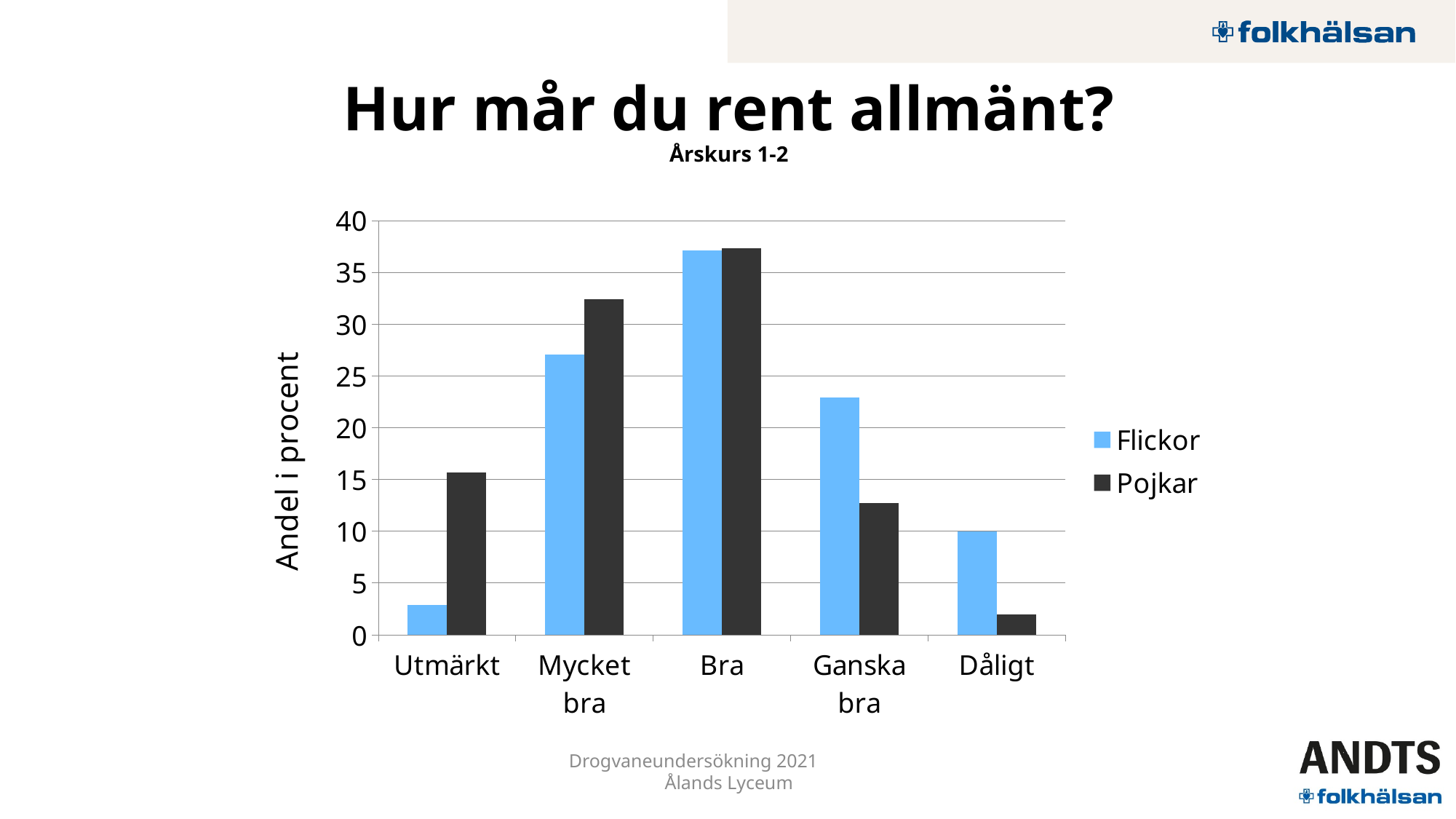
What kind of chart is shown on the slide? bar chart Which category has the lowest value for Pojkar? Dåligt For Utmärkt, which series has the larger value, Flickor or Pojkar? Pojkar Which category has the lowest value for Flickor? Utmärkt For Ganska bra, which series has the larger value, Flickor or Pojkar? Flickor What is the label of the y axis? Andel i procent How many series does the legend list? 2 How many categories are shown on the x axis? 5 Is the value for Pojkar in Mycket bra greater or less than 30? greater Which category has the highest value for Pojkar? Bra Which category has the highest value for Flickor? Bra Is the value for Flickor in Utmärkt greater or less than 5? less